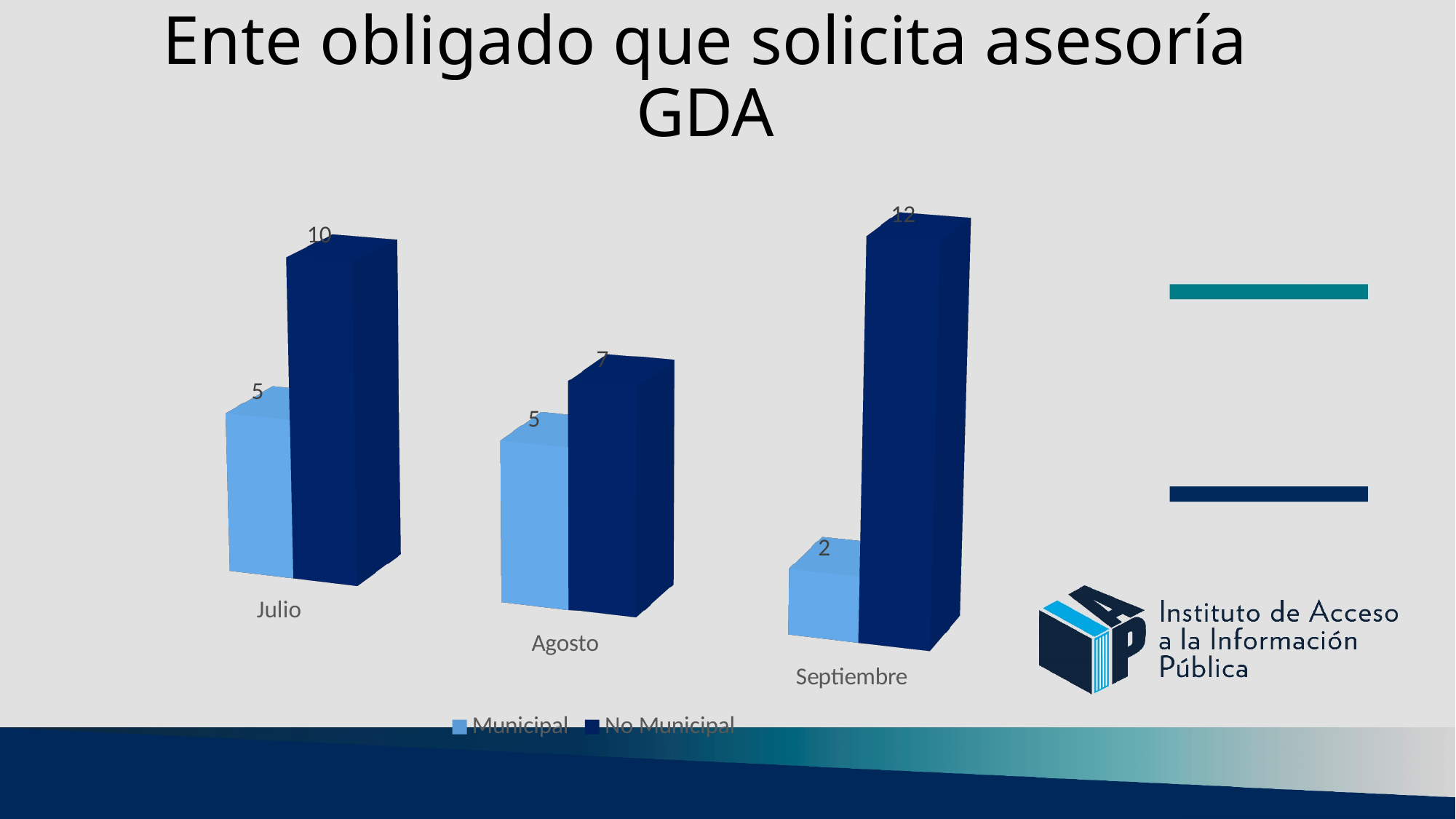
What is the difference between No Municipal and Municipal in Septiembre? 10 Which month has the lowest Municipal value? Septiembre How many series does the legend list? 2 What is the value for Municipal in Julio? 5 What is the value for Municipal in Septiembre? 2 What kind of chart is shown on the slide? Bar chart How many months are shown on the x axis? 3 What is the title of the chart? Ente obligado que solicita asesoría GDA Which is larger in Julio, Municipal or No Municipal? No Municipal Which month has the highest No Municipal value? Septiembre What is the value for No Municipal in Septiembre? 12 What is the value for No Municipal in Agosto? 7